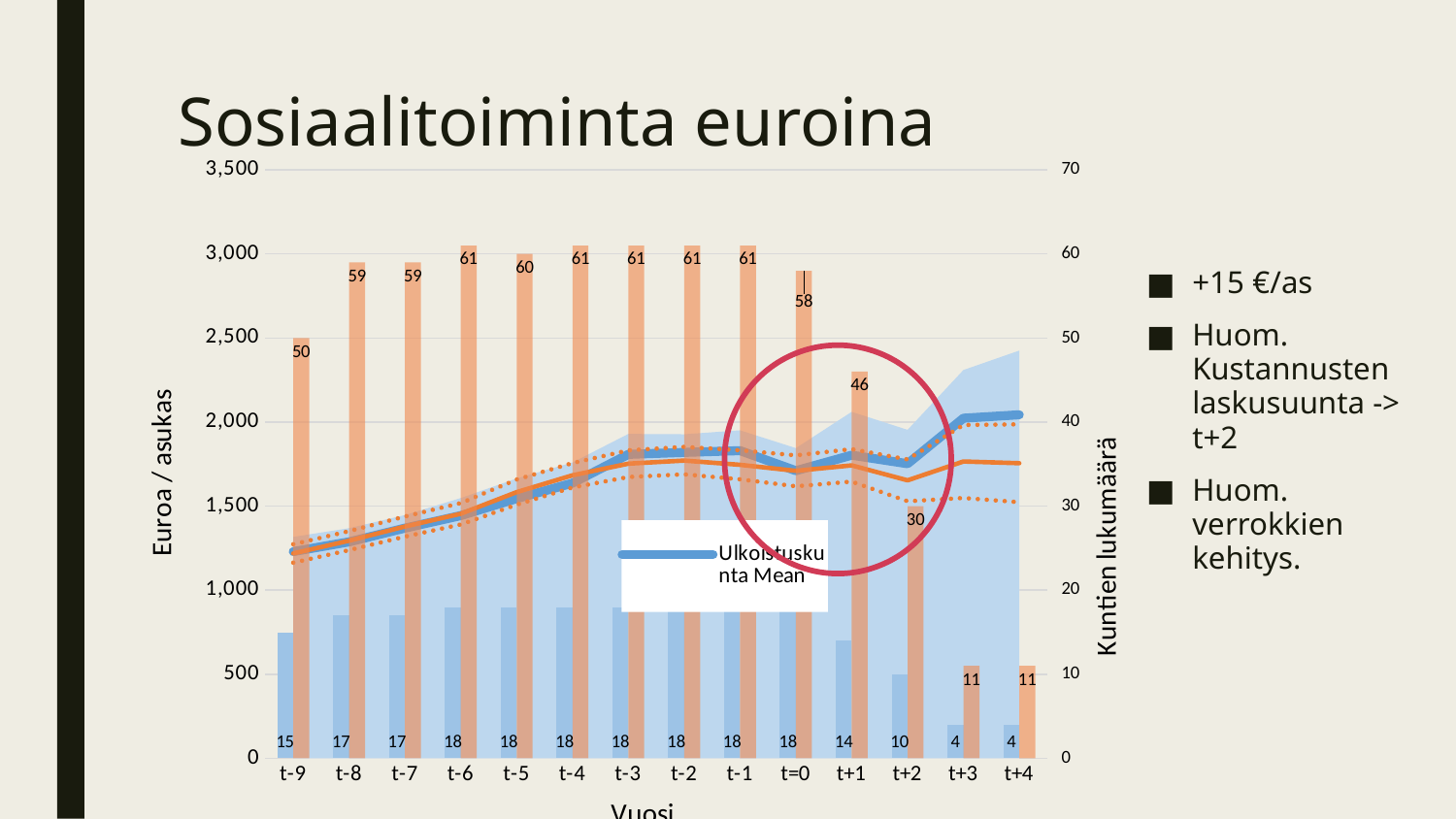
Which is larger, the orange bar value at t-8 or at t+1? t-8 What is the data label on the blue bar at t+2? 10 What is the difference between the blue bar values at t-9 and t-6? 3 How many categories are shown on the x axis? 14 What is the data label on the orange bar at t-9? 50 What is the title of the chart? Sosiaalitoiminta euroina What is the label of the right-hand vertical axis? Kuntien lukumäärä What is the data label on the blue bar at t-6? 18 Which category has the lowest orange bar value? t+3 and t+4 (11) What is the data label on the orange bar at t+1? 46 What is the difference between the orange bar values at t=0 and t+2? 28 Do the orange bar values rise or fall from t=0 to t+4? fall